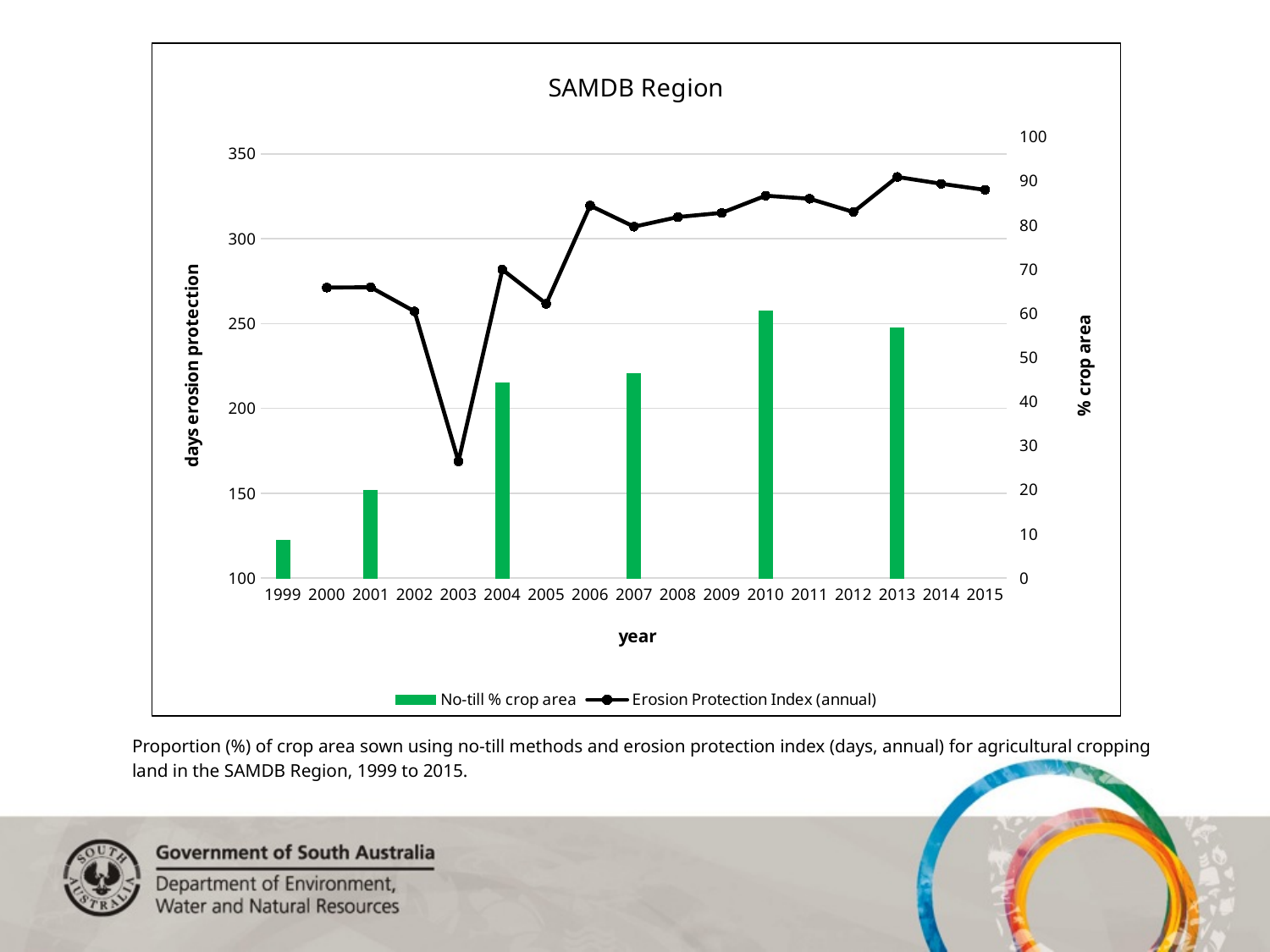
Is the No-till % crop area for 2013 greater or less than 50? greater In which year is the No-till % crop area bar highest? 2010 Which year has the larger No-till % crop area, 2010 or 2013? 2010 In which year is the No-till % crop area bar lowest? 1999 Is the Erosion Protection Index (annual) for 2003 greater or less than 200? less What is the title of the chart? SAMDB Region What kind of chart is shown on the slide? A combined bar and line chart Is the Erosion Protection Index (annual) for 2006 greater or less than 300? greater How many years are labelled on the x axis? 17 In which year is the Erosion Protection Index (annual) lowest? 2003 How many bars for No-till % crop area are plotted? 6 How many series does the legend list? 2